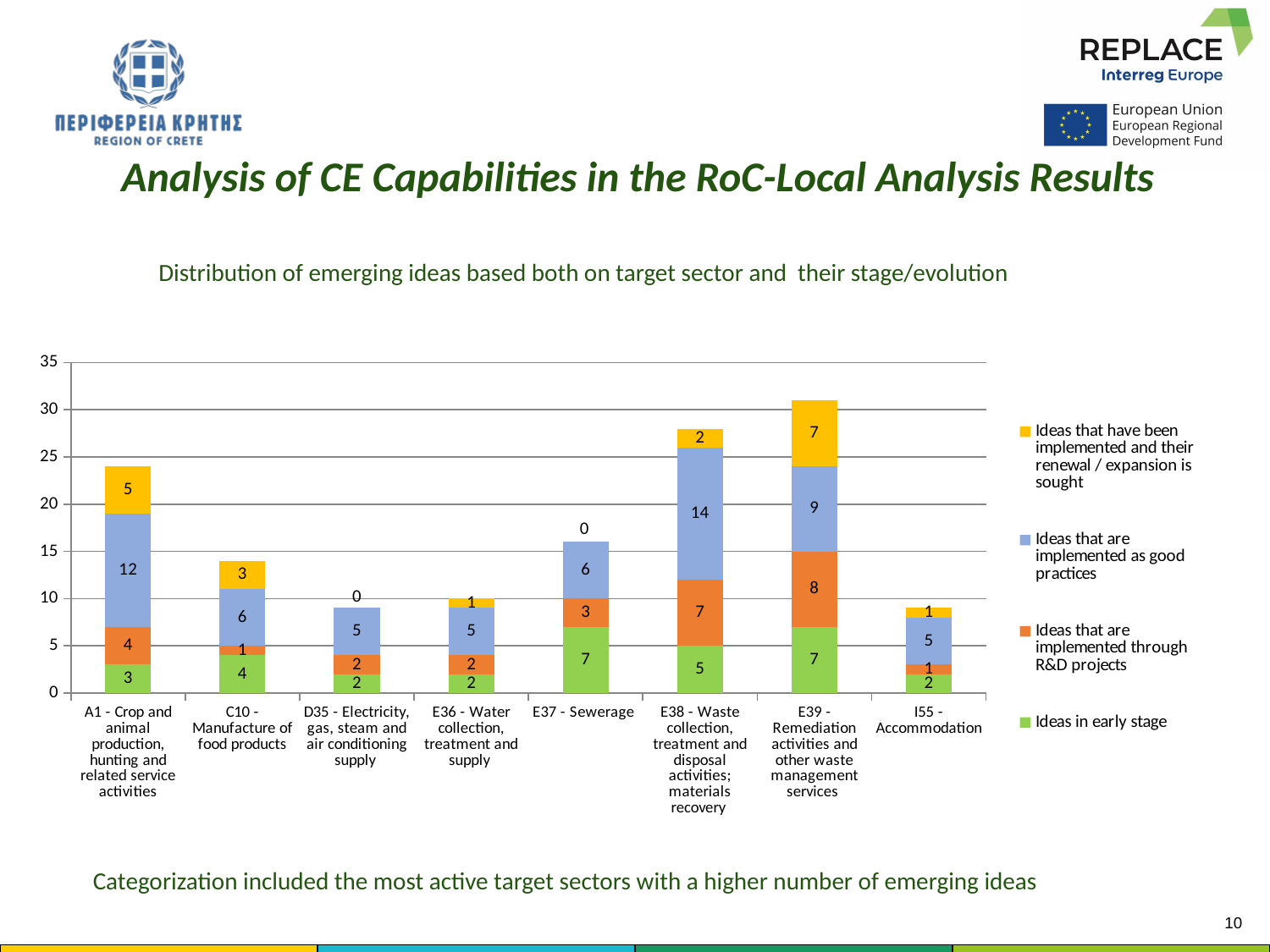
What is the difference between the 'Ideas that are implemented through R&D projects' values for E39 - Remediation activities and C10 - Manufacture of food products? 7 Is the total stacked bar for E38 - Waste collection, treatment and disposal activities greater or less than 25? greater What is the total of the stacked bar for A1 - Crop and animal production, hunting and related service activities? 24 What is the value of 'Ideas in early stage' for E37 - Sewerage? 7 What is the total of the stacked bar for E39 - Remediation activities and other waste management services? 31 How many series does the legend list? 4 What is the value of 'Ideas that have been implemented and their renewal / expansion is sought' for E39 - Remediation activities and other waste management services? 7 What is the value of 'Ideas that are implemented as good practices' for E38 - Waste collection, treatment and disposal activities; materials recovery? 14 How many target sectors (categories) are shown on the x axis? 8 Which is larger: the 'Ideas that are implemented as good practices' value for A1 - Crop and animal production or for E39 - Remediation activities? A1 - Crop and animal production Which sector has the highest total stacked bar? E39 - Remediation activities and other waste management services What kind of chart is shown on the slide? stacked bar chart